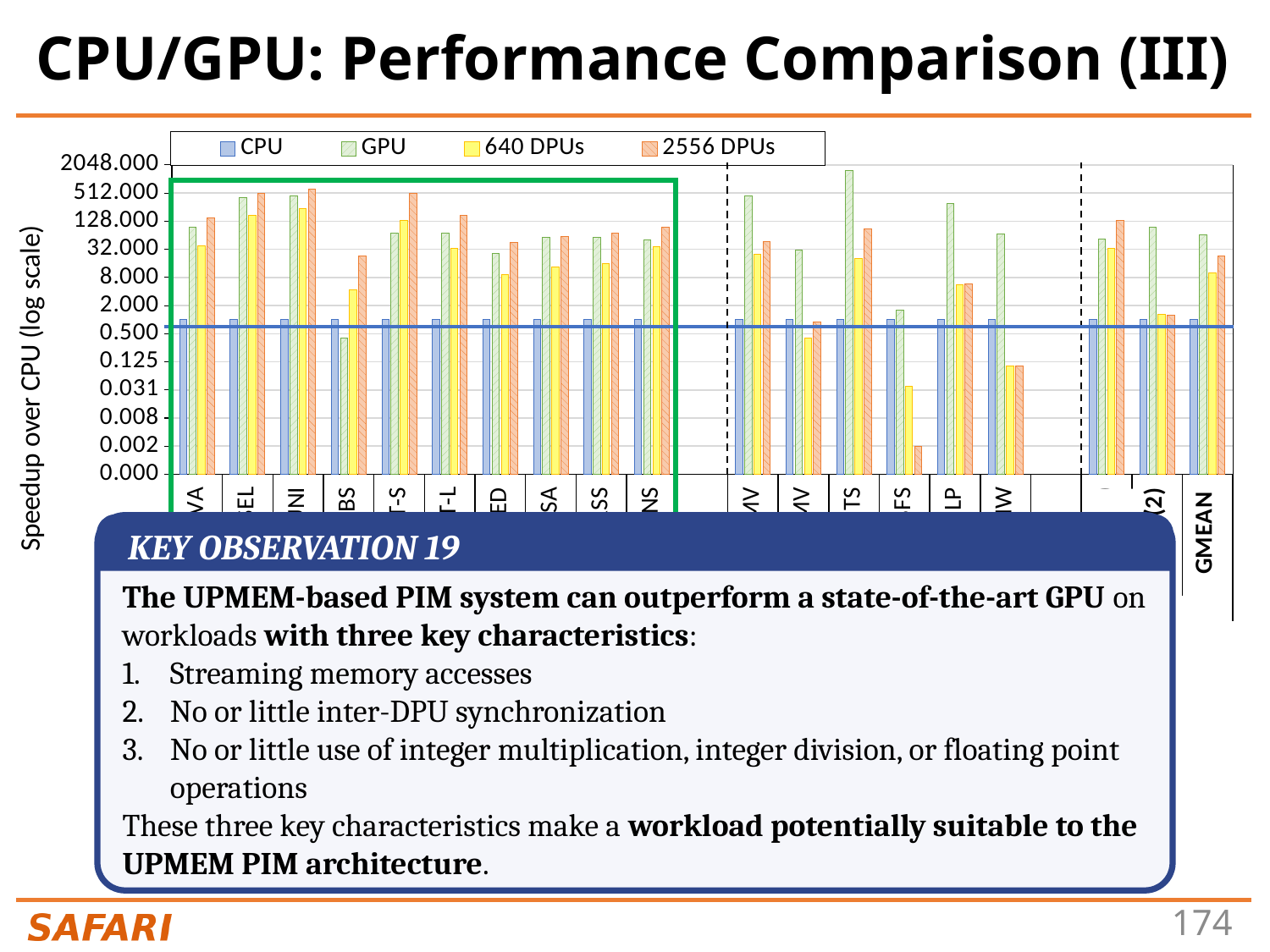
Is the 640 DPUs value for GMEAN greater or less than 128? less Is the 2556 DPUs value for GMEAN greater or less than 128? less What are the series listed in the chart's legend? CPU, GPU, 640 DPUs, 2556 DPUs For GMEAN, which is larger: the GPU value or the 640 DPUs value? GPU Is the GPU value for BS greater or less than 0.500? less How many series does the chart's legend list? 4 What is the label of the chart's y axis? Speedup over CPU (log scale) What kind of chart is shown on the slide? bar chart For GMEAN, which is larger: the GPU value or the 2556 DPUs value? GPU For GMEAN, which is larger: the 640 DPUs value or the 2556 DPUs value? 2556 DPUs